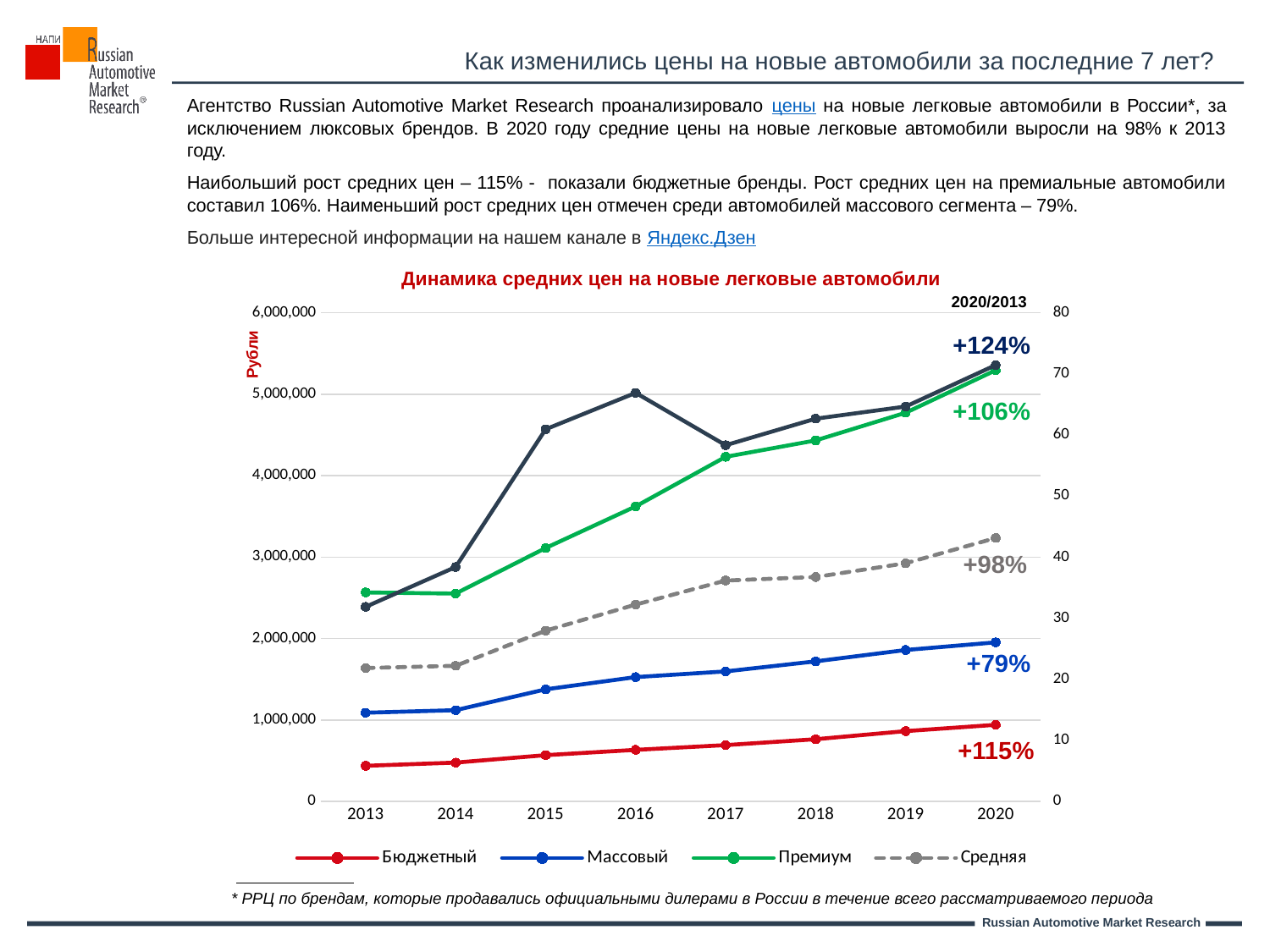
Does the Бюджетный line rise or fall from 2013 to 2020? rises Is the value for Массовый in 2013 greater or less than 2,000,000? less What kind of chart is shown on the slide? line chart What is the 2020/2013 growth shown for the Бюджетный series? +115% How many years are plotted along the x axis of the chart? 8 What is the title of the chart? Динамика средних цен на новые легковые автомобили What is the 2020/2013 growth shown for the Премиум series? +106% Is the value for Премиум in 2020 greater or less than 5,000,000? greater What is the 2020/2013 growth shown for the Массовый series? +79% In 2020, which is larger: the value for Премиум or the value for Массовый? Премиум What is the 2020/2013 growth shown for the Средняя series? +98% How many series does the chart legend list? 4